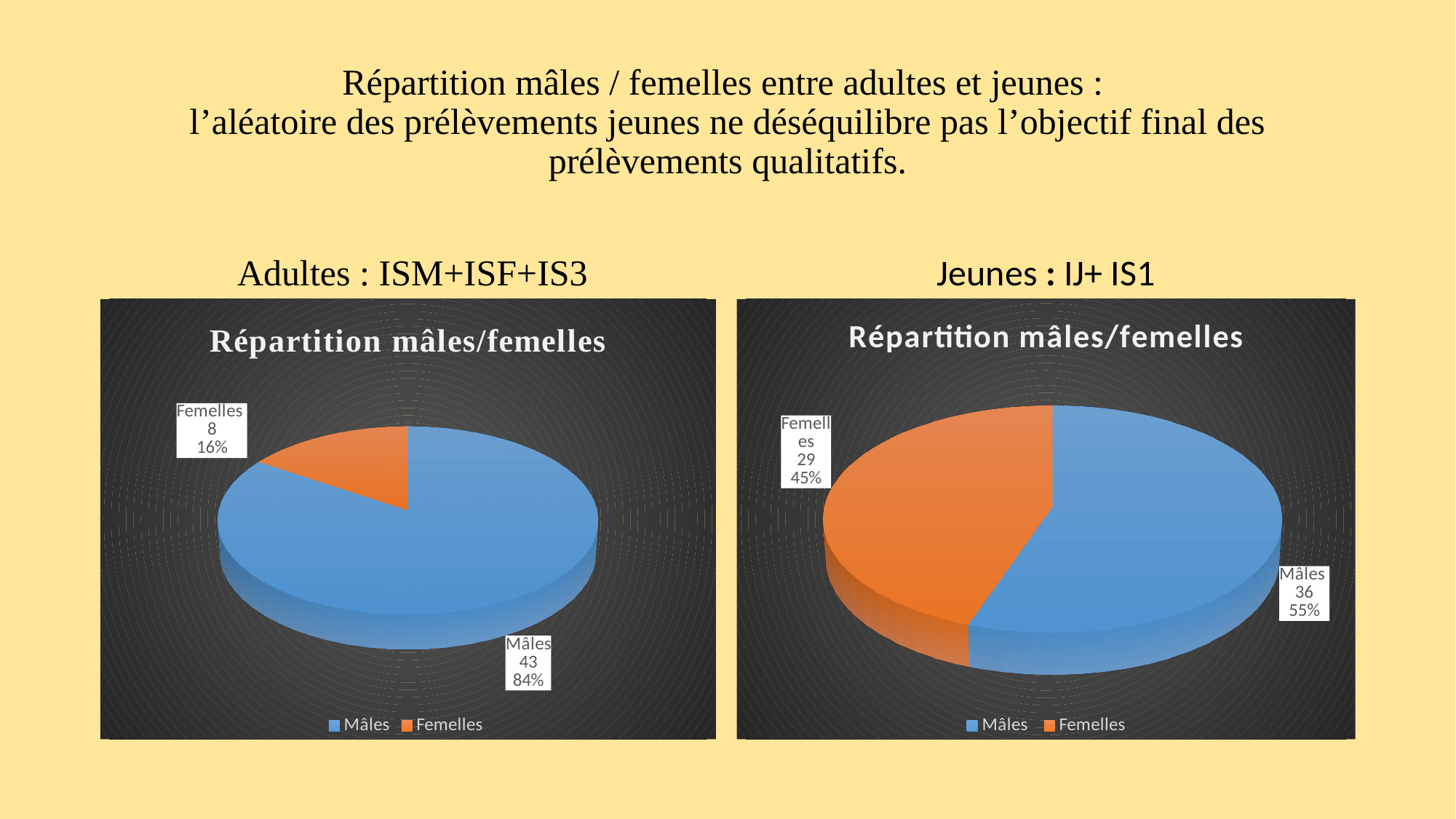
In the right chart (Jeunes : IJ+ IS1), what is the value for Mâles? 36 In the left chart (Adultes : ISM+ISF+IS3), what is the value for Mâles? 43 In the right chart (Jeunes : IJ+ IS1), what is the value for Femelles? 29 In the left chart (Adultes : ISM+ISF+IS3), what is the difference between the Mâles and Femelles values? 35 In the left chart (Adultes : ISM+ISF+IS3), what share of the pie do Mâles represent? 84% In the left chart (Adultes : ISM+ISF+IS3), which category is the largest? Mâles In the right chart (Jeunes : IJ+ IS1), what is the total of Mâles and Femelles? 65 What kind of chart is the left chart (Adultes : ISM+ISF+IS3)? Pie chart In the right chart (Jeunes : IJ+ IS1), which category is the smallest? Femelles In the right chart (Jeunes : IJ+ IS1), what share of the pie do Femelles represent? 45% How many entries does the legend of the right chart (Jeunes : IJ+ IS1) list? 2 In the left chart (Adultes : ISM+ISF+IS3), what is the value for Femelles? 8